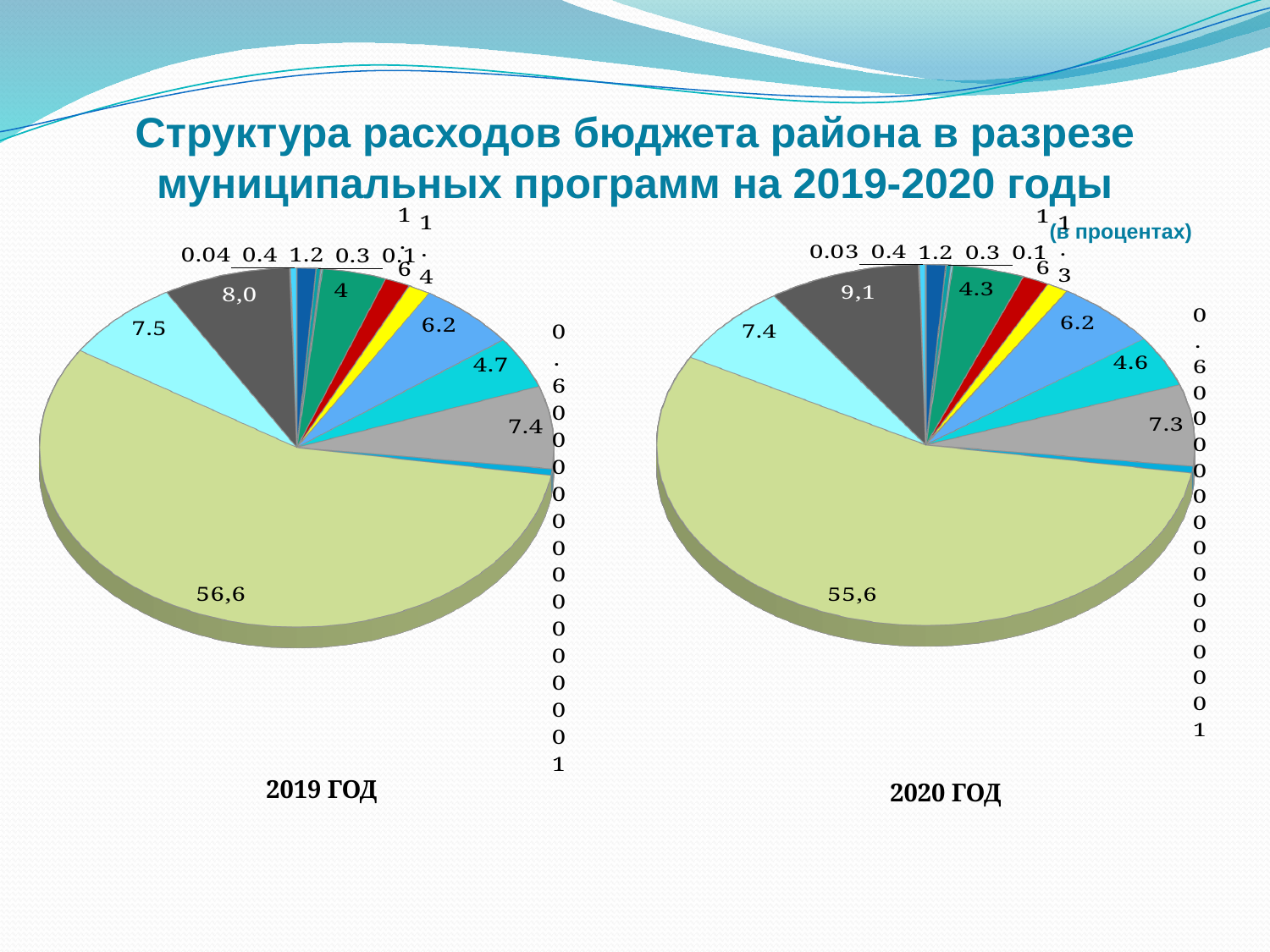
Which chart has the larger value for its largest slice, 2019 ГОД or 2020 ГОД? 2019 ГОД In the 2019 ГОД chart, what is the smallest labelled value? 0.04 In the 2019 ГОД chart, what is the value of the largest slice (light green)? 56,6 In the 2020 ГОД chart, what is the value of the largest slice (light green)? 55,6 In the 2020 ГОД chart, what is the value of the dark green slice? 4.3 In the 2019 ГОД chart, what is the value of the light cyan slice? 7.5 In what units are the values on the charts given, according to the note on the slide? в процентах What kind of chart is the 2019 ГОД chart on the left? pie chart In the 2020 ГОД chart, what is the value of the light cyan slice? 7.4 In the 2020 ГОД chart, what is the value of the dark grey slice? 9,1 In the 2019 ГОД chart, what is the value of the dark grey slice? 8,0 In the 2020 ГОД chart, what is the smallest labelled value? 0.03